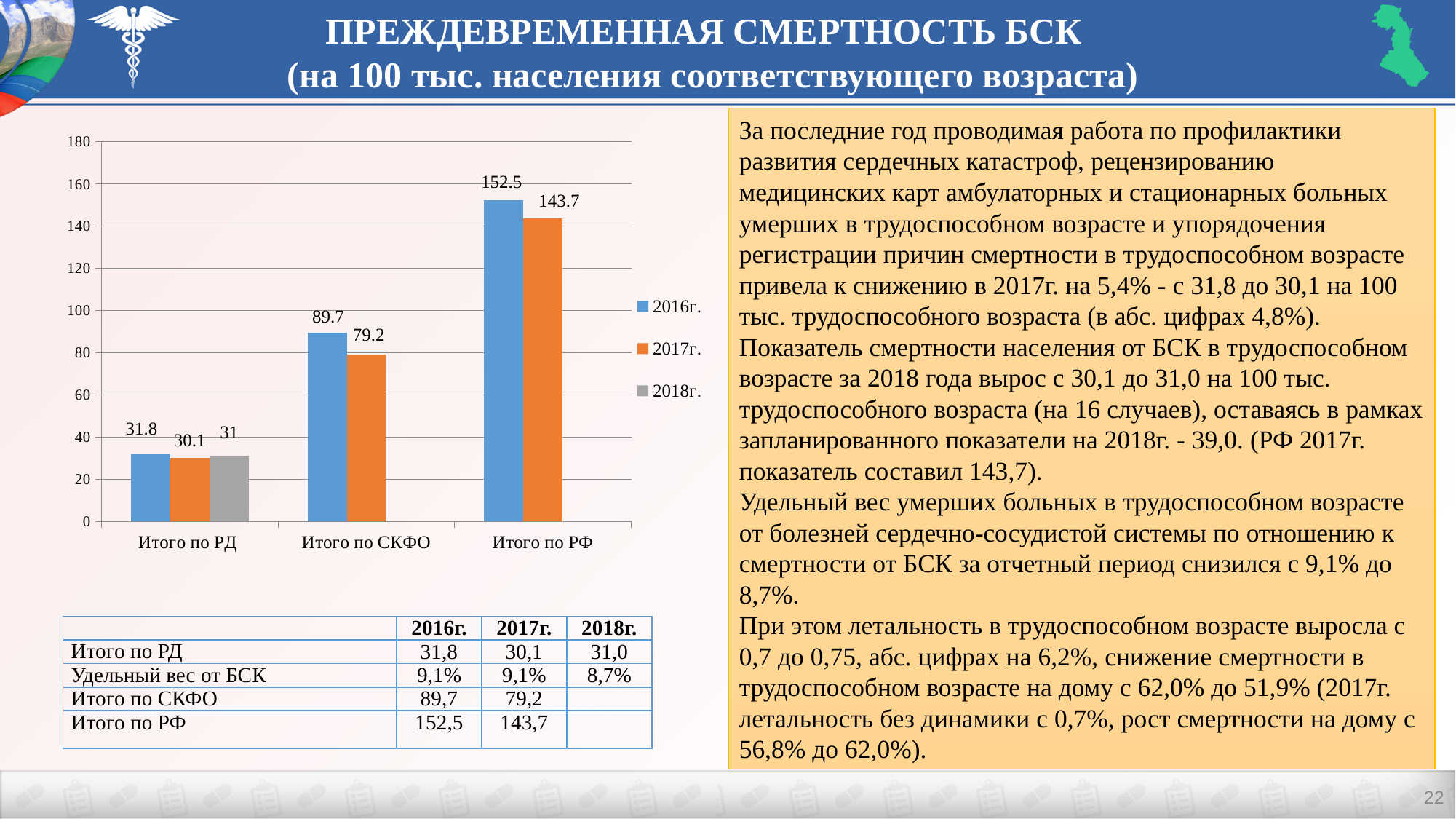
Is the 2017г. value for Итого по РФ greater or less than 140? greater What is the value for Итого по СКФО in the 2017г. series? 79.2 How many categories are shown on the x axis of the chart? 3 What is the value for Итого по РД in the 2018г. series? 31 What is the value for Итого по РД in the 2016г. series? 31.8 How many series does the chart legend list? 3 What kind of chart is shown on the slide? Bar chart Which category has the highest value in the 2017г. series? Итого по РФ What is the difference between the 2016г. and 2017г. values for Итого по РФ? 8.8 What is the value for Итого по РФ in the 2016г. series? 152.5 Which is larger for Итого по СКФО: the 2016г. value or the 2017г. value? 2016г. Which category has the lowest value in the 2016г. series? Итого по РД